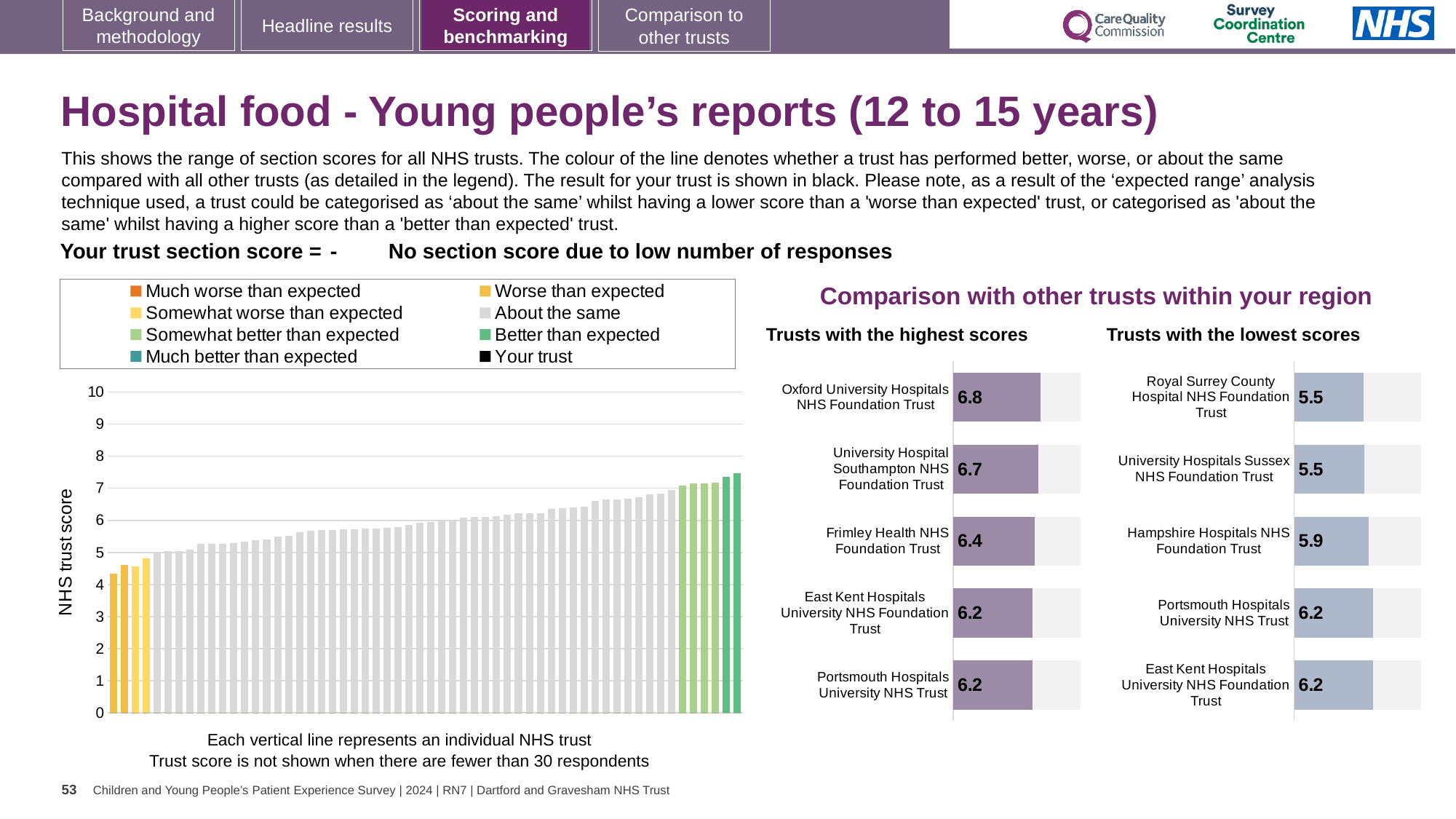
How many entries does the legend above the 'NHS trust score' chart list? 8 In the 'NHS trust score' chart on the left, do the bar values rise or fall from left to right? Rise In the 'Trusts with the lowest scores' chart, what is the difference between the scores of Hampshire Hospitals NHS Foundation Trust and Royal Surrey County Hospital NHS Foundation Trust? 0.4 What kind of chart is the large chart on the left with the 'NHS trust score' axis? Bar chart In the 'Trusts with the lowest scores' chart, which has the higher score: Hampshire Hospitals NHS Foundation Trust or University Hospitals Sussex NHS Foundation Trust? Hampshire Hospitals NHS Foundation Trust In the 'Trusts with the lowest scores' chart, what is the score for Hampshire Hospitals NHS Foundation Trust? 5.9 In the 'NHS trust score' chart on the left, is the value of the leftmost bar greater or less than 5? less How many trusts are shown in the 'Trusts with the lowest scores' chart? 5 In the 'Trusts with the highest scores' chart, what is the difference between the scores of Oxford University Hospitals NHS Foundation Trust and University Hospital Southampton NHS Foundation Trust? 0.1 In the 'Trusts with the highest scores' chart, what is the score for Frimley Health NHS Foundation Trust? 6.4 In the 'Trusts with the highest scores' chart, which trust has the highest score? Oxford University Hospitals NHS Foundation Trust In the 'Trusts with the highest scores' chart, what is the score for Oxford University Hospitals NHS Foundation Trust? 6.8